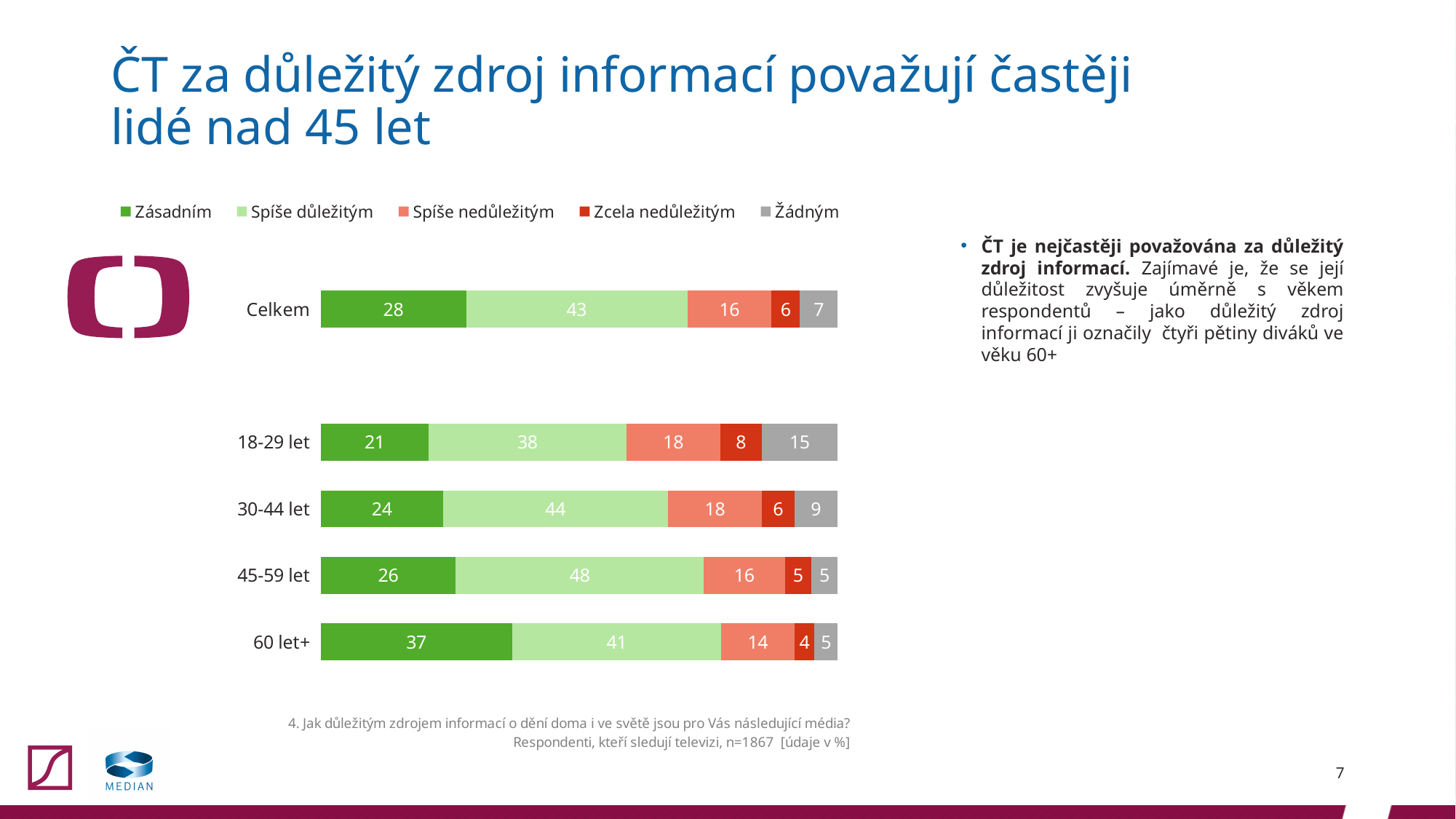
What is the value for "Zásadním" in the "60 let+" bar? 37 How many series does the legend list? 5 Which is larger: the "Spíše důležitým" value for "45-59 let" or for "30-44 let"? 45-59 let What is the value for "Žádným" in the "18-29 let" bar? 15 Which age group has the highest value for "Zásadním"? 60 let+ How many categories (bars) are shown in the chart? 5 Which category has the lowest value for "Zcela nedůležitým"? 60 let+ What is the total of the "Celkem" stacked bar? 100 What is the value for "Spíše důležitým" in the "Celkem" bar? 43 What kind of chart is shown on the slide? Stacked bar chart Which legend entry is shown in grey? Žádným What is the difference between the "Zásadním" values for "60 let+" and "18-29 let"? 16